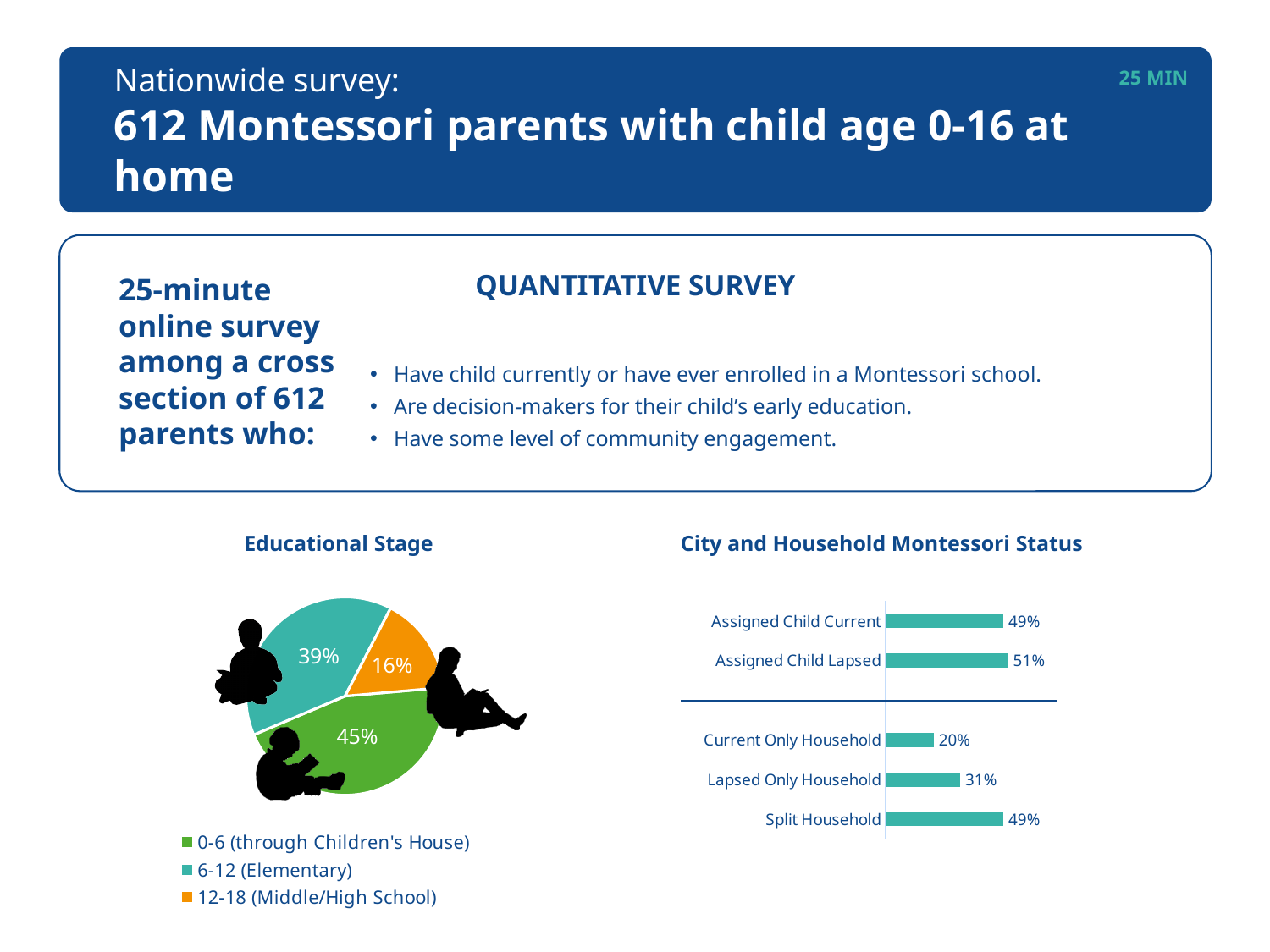
How many slices does the Educational Stage pie chart have? 3 In the City and Household Montessori Status chart, which is larger: Assigned Child Current or Assigned Child Lapsed? Assigned Child Lapsed What kind of chart is the Educational Stage chart? Pie chart In the Educational Stage chart, which educational stage has the smallest slice? 12-18 (Middle/High School) In the Educational Stage chart, which educational stage has the largest slice? 0-6 (through Children's House) In the City and Household Montessori Status chart, what is the value for Current Only Household? 20% What kind of chart is the City and Household Montessori Status chart? Bar chart In the Educational Stage chart, what share is shown for 6-12 (Elementary)? 39% In the City and Household Montessori Status chart, what is the difference between Lapsed Only Household and Current Only Household? 11% In the City and Household Montessori Status chart, what is the value for Assigned Child Lapsed? 51% In the City and Household Montessori Status chart, which category has the lowest value? Current Only Household In the Educational Stage chart, what share of parents have a child in the 0-6 (through Children's House) stage? 45%